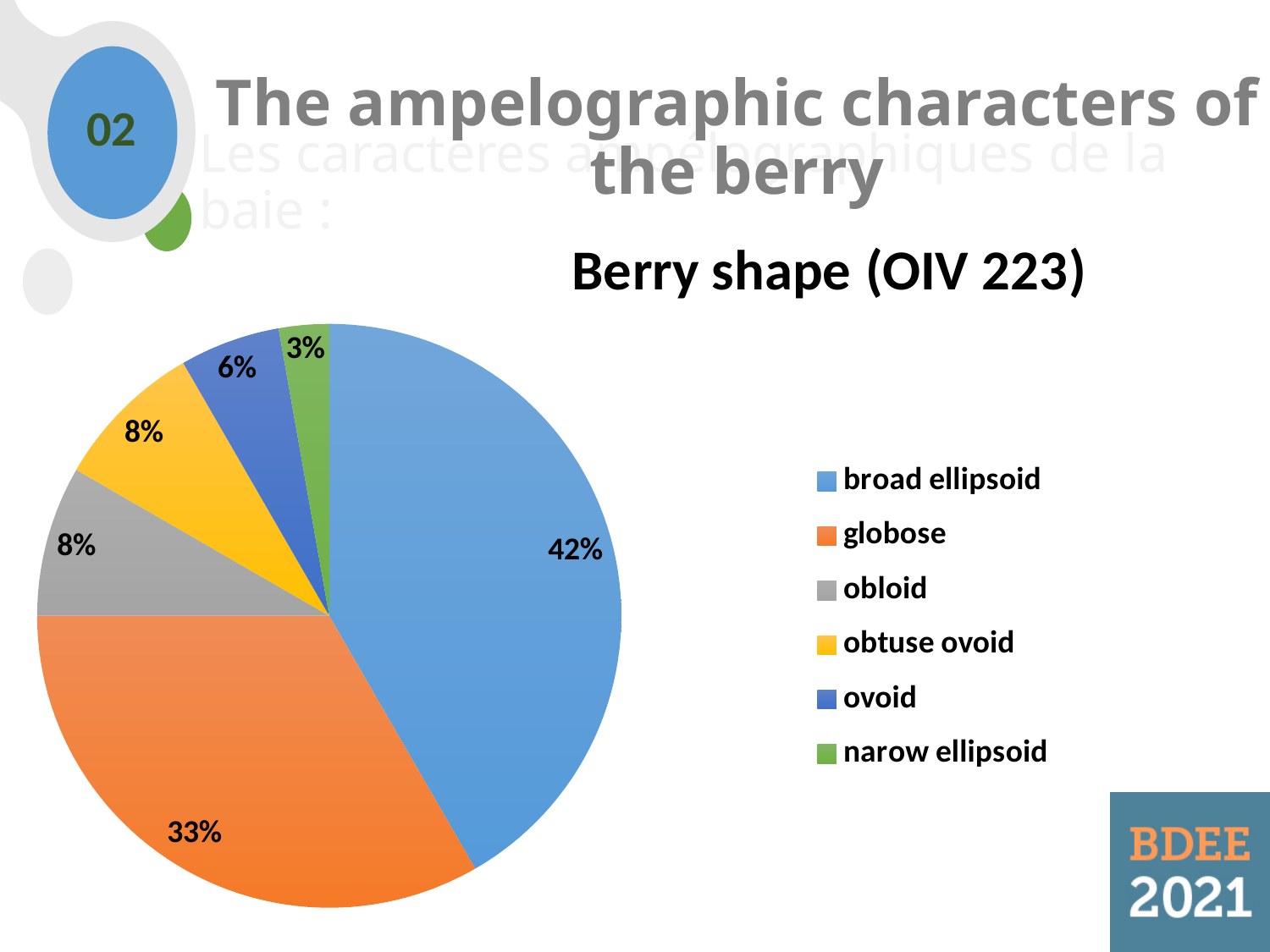
What share of the pie does narow ellipsoid have? 3% What kind of chart is shown on the slide? pie chart What share of the pie does obtuse ovoid have? 8% Which berry shape has the largest share of the pie? broad ellipsoid What is the title of the chart? Berry shape (OIV 223) How many berry shape categories does the legend list? 6 What share of the pie does ovoid have? 6% Which berry shape has the smallest share of the pie? narow ellipsoid Which has a larger share, ovoid or obloid? obloid What is the difference in percentage points between broad ellipsoid and globose? 9